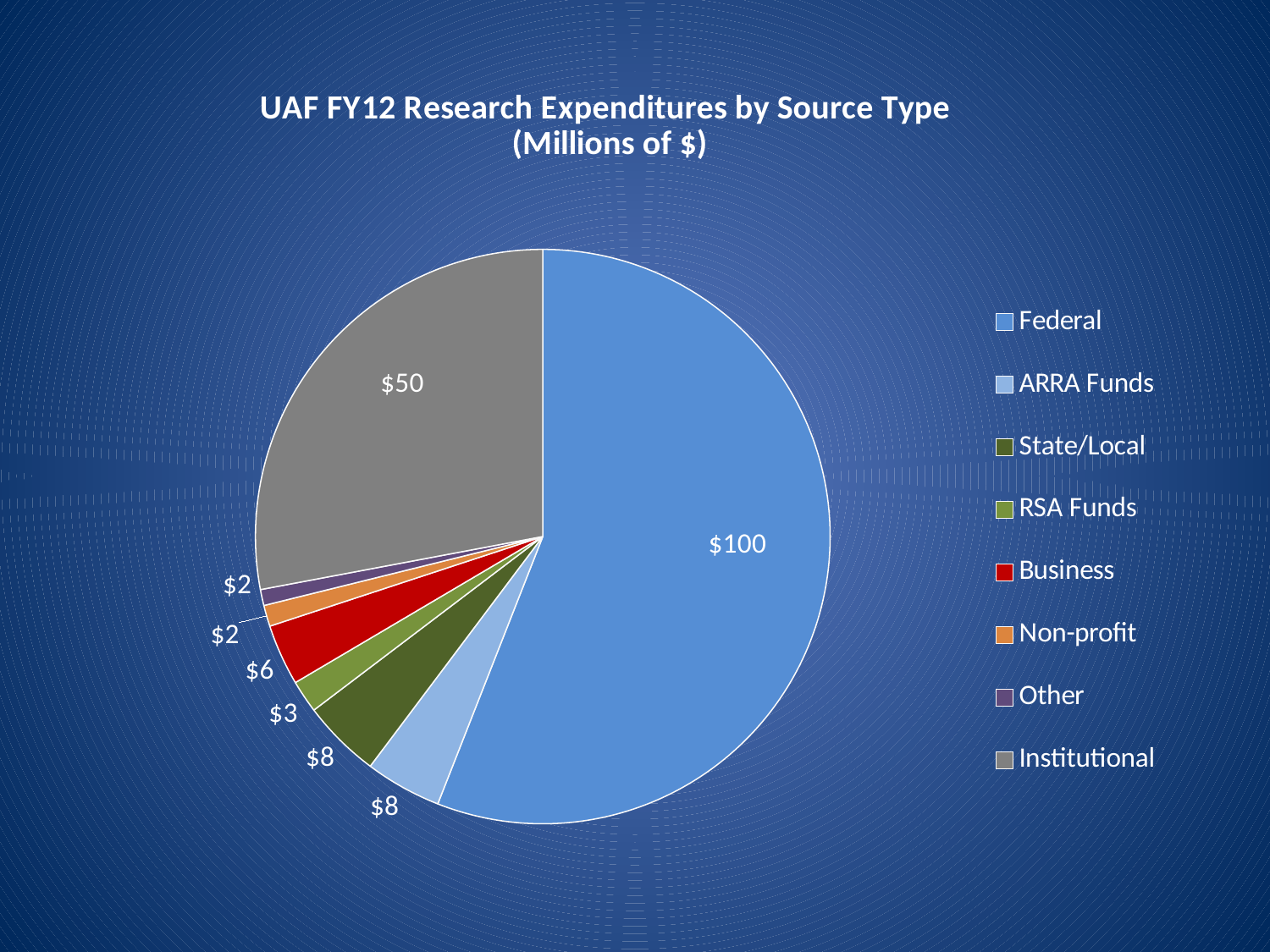
What is the value for RSA Funds in the pie chart? $3 What is the difference between the Business and RSA Funds values? $3 What is the value for Business in the pie chart? $6 Which is larger, the Business slice or the RSA Funds slice? Business What is the value for Non-profit in the pie chart? $2 What is the value for Institutional in the pie chart? $50 What is the title of the chart? UAF FY12 Research Expenditures by Source Type (Millions of $) What is the difference between the Federal and Institutional values? $50 How many source types (slices) are shown in the pie chart? 8 What is the value for Federal in the pie chart? $100 Which source type has the largest slice of the pie? Federal What type of chart is shown on the slide? Pie chart